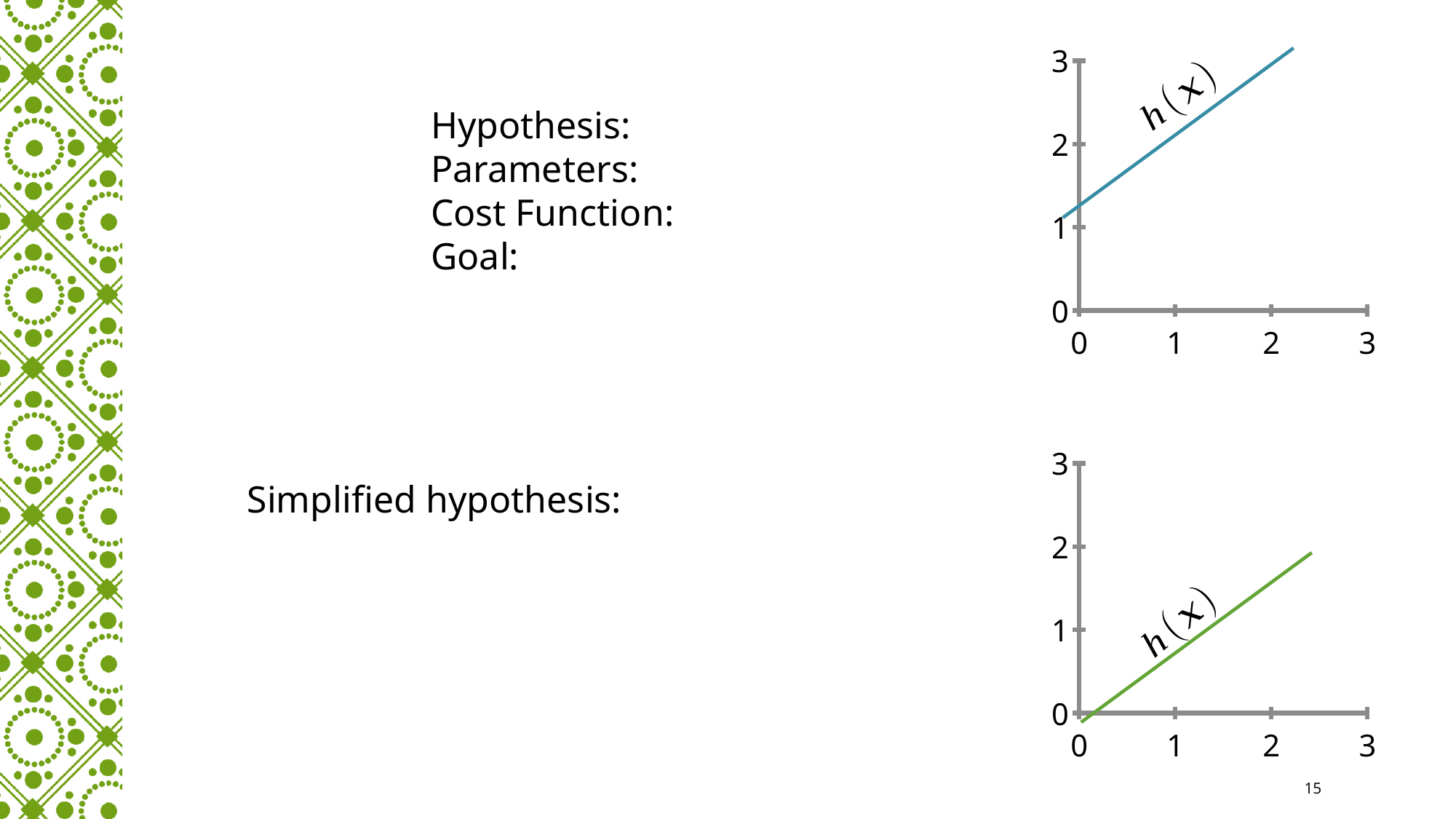
What colour is the line in the bottom chart? green In the bottom chart, does h(x) rise or fall as x increases? rise In the top chart, is the value of h(x) at x = 2 greater or less than 2? greater In the top chart, does h(x) rise or fall as x increases? rise In the bottom chart, is the value of h(x) at x = 2 greater or less than 2? less In the top chart, is the value of h(x) at x = 0 greater or less than 0? greater How many charts are shown on the slide? 2 What kind of chart is the bottom chart on the slide? line chart What is the highest value shown on the y axis of the top chart? 3 What kind of chart is the top chart on the slide? line chart